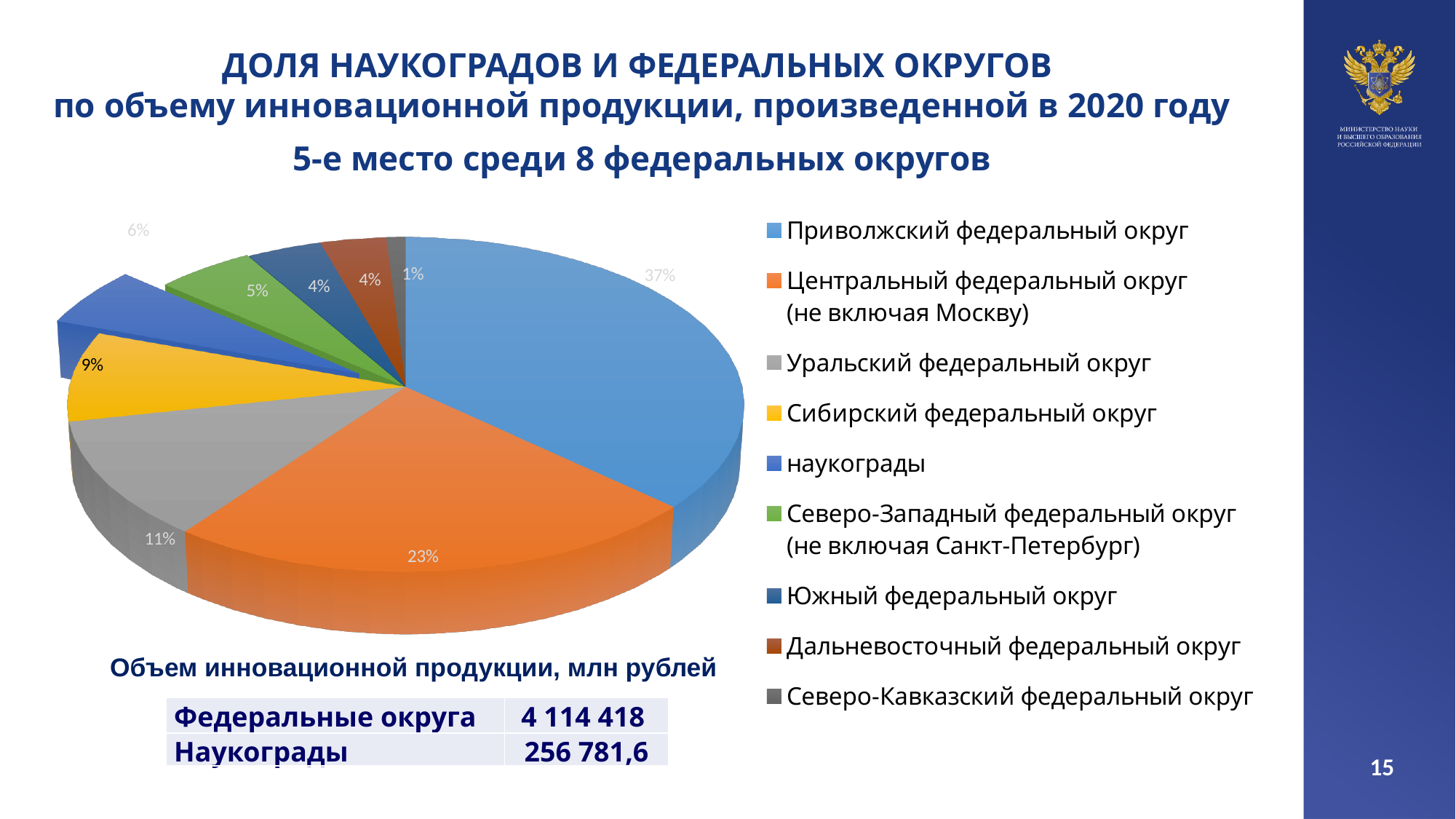
What share of the pie does Уральский федеральный округ have? 11% Which slice of the pie is pulled out (exploded) from the rest? наукограды What is the difference in percentage points between the shares of Приволжский федеральный округ and Центральный федеральный округ (не включая Москву)? 14 Which category has the smallest slice of the pie? Северо-Кавказский федеральный округ What share of the pie does Центральный федеральный округ (не включая Москву) have? 23% Which category has the largest slice of the pie? Приволжский федеральный округ What share of the pie does Северо-Кавказский федеральный округ have? 1% What kind of chart is shown on the slide? pie chart How many entries does the legend list? 9 Which has a larger share: Сибирский федеральный округ or наукограды? Сибирский федеральный округ